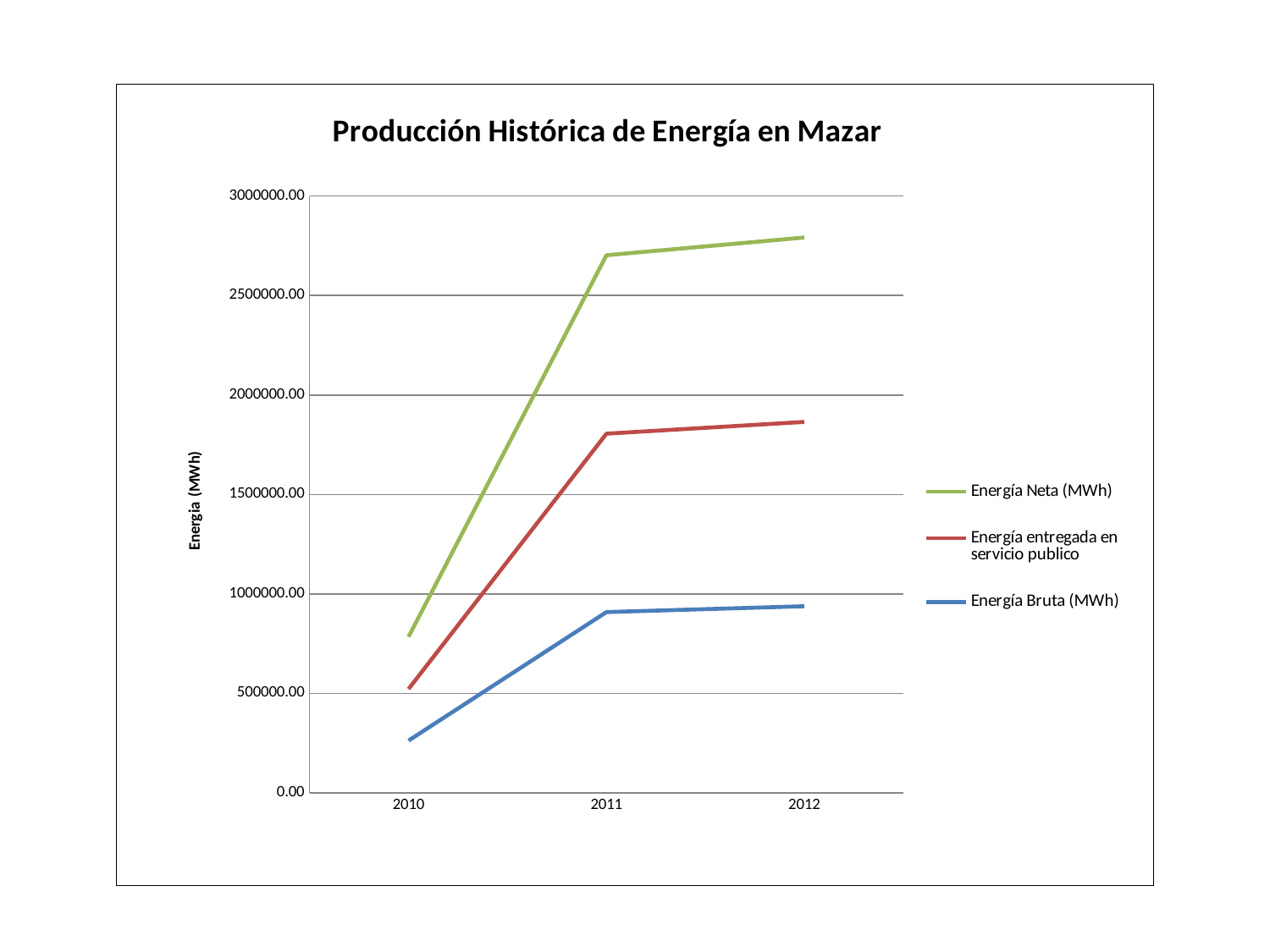
Is the value for Energía Bruta (MWh) in 2010 greater or less than 500000.00? less How many years are plotted along the x axis? 3 How many series does the legend list? 3 Do the values for Energía Bruta (MWh) rise or fall from 2010 to 2012? rise What kind of chart is shown on the slide? line chart What is the title of the chart? Producción Histórica de Energía en Mazar In which year is the value for Energía Neta (MWh) lowest? 2010 Is the value for Energía entregada en servicio publico in 2012 greater or less than 2000000.00? less What is the label on the vertical axis? Energía (MWh) Is the value for Energía Neta (MWh) in 2010 greater or less than 1000000.00? less